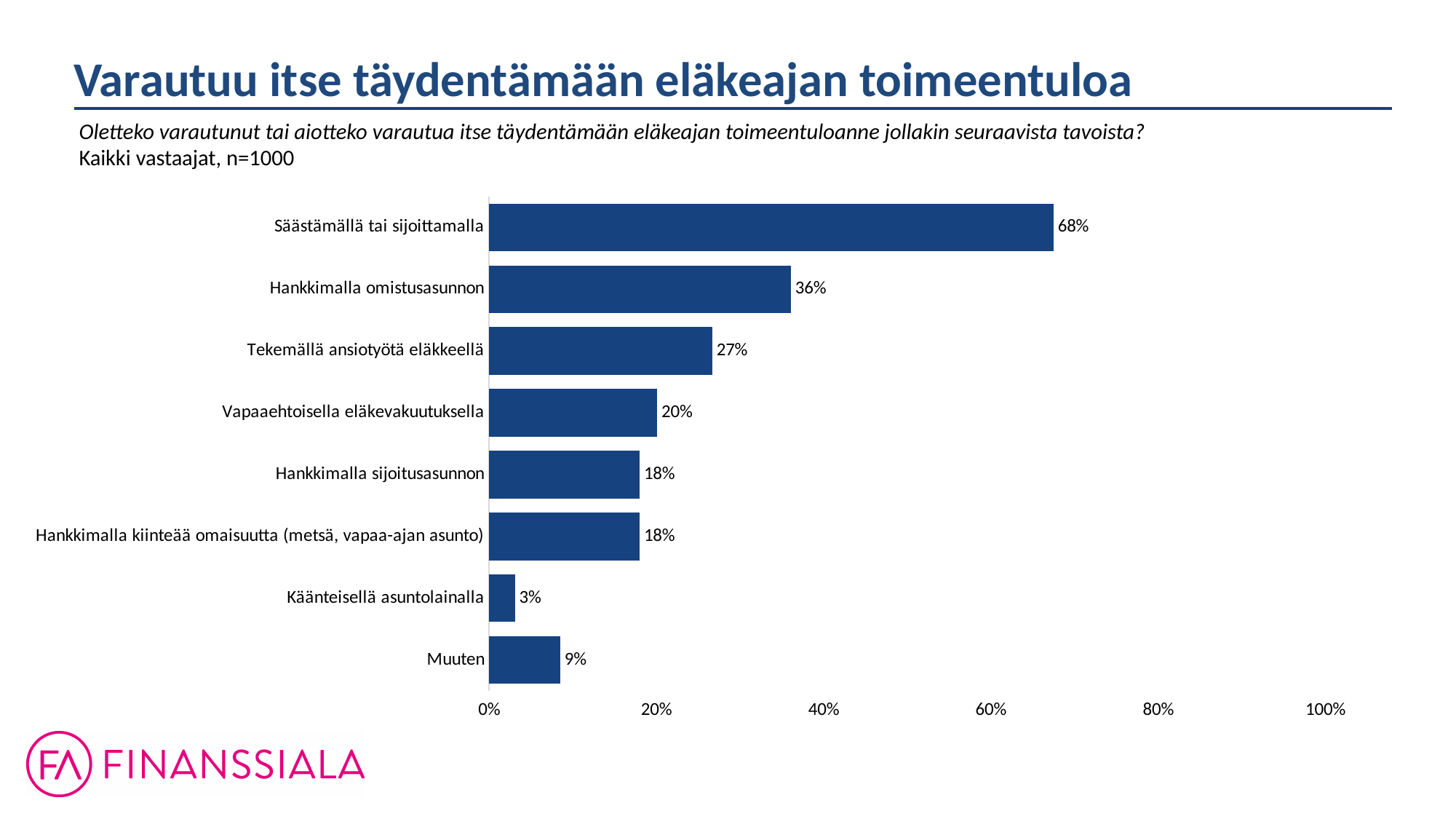
Is the value for Hankkimalla omistusasunnon greater or less than 40%? less What is the value for Säästämällä tai sijoittamalla? 68% What is the difference between Säästämällä tai sijoittamalla and Hankkimalla omistusasunnon? 32% How many categories are shown in the chart? 8 What is the sample size stated on the slide? n=1000 Which category has the lowest value? Käänteisellä asuntolainalla Which category has the highest value? Säästämällä tai sijoittamalla What is the value for Käänteisellä asuntolainalla? 3% Which is larger, Tekemällä ansiotyötä eläkkeellä or Muuten? Tekemällä ansiotyötä eläkkeellä What is the value for Vapaaehtoisella eläkevakuutuksella? 20% What is the value for Hankkimalla omistusasunnon? 36% What kind of chart is shown on the slide? bar chart